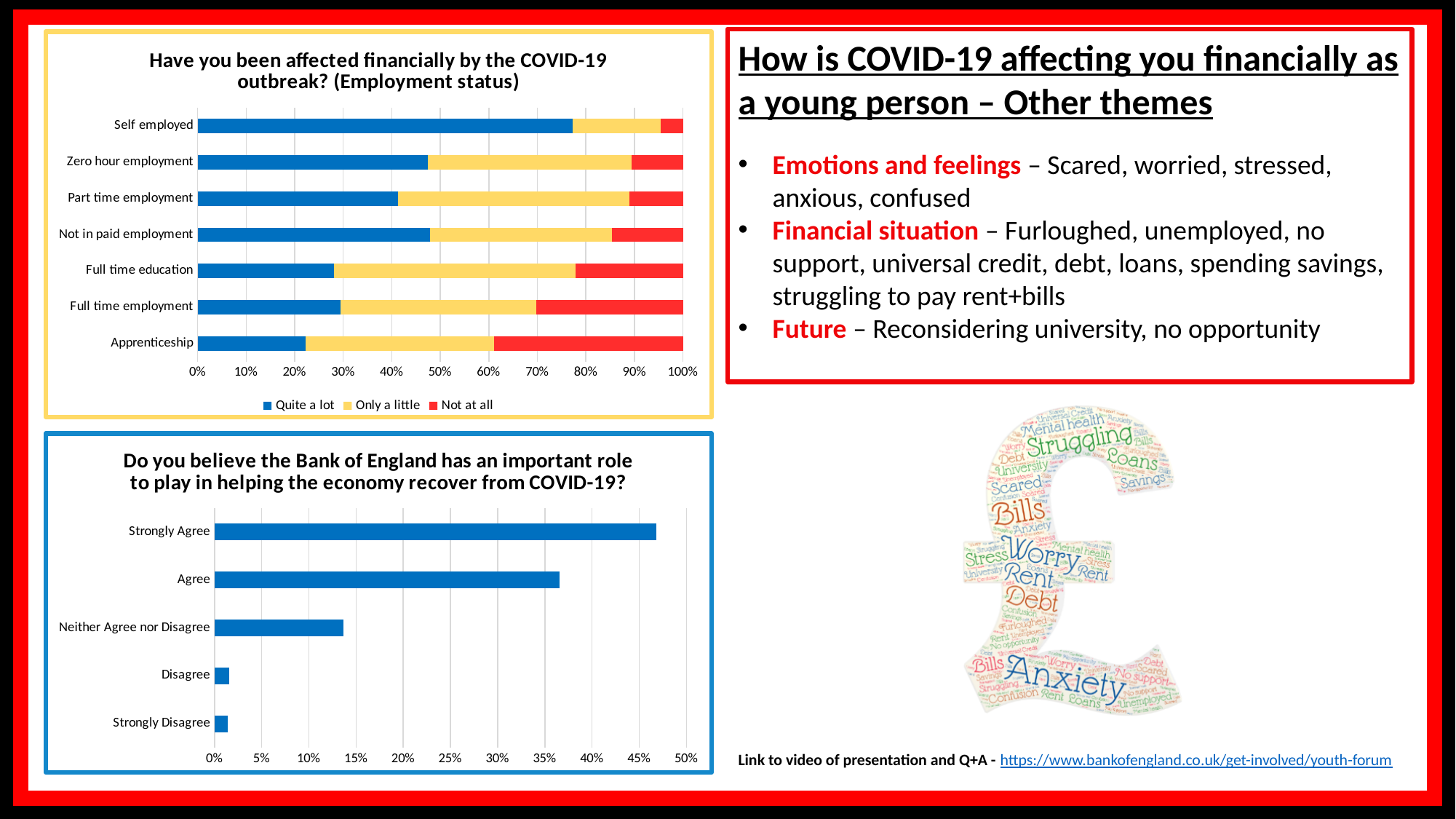
In the chart titled 'Have you been affected financially by the COVID-19 outbreak? (Employment status)', which has the larger 'Quite a lot' share: Zero hour employment or Part time employment? Zero hour employment In the chart titled 'Have you been affected financially by the COVID-19 outbreak? (Employment status)', is the 'Quite a lot' share for Self employed greater or less than 70%? greater In the chart titled 'Have you been affected financially by the COVID-19 outbreak? (Employment status)', which employment status has the smallest 'Quite a lot' share? Apprenticeship In the chart titled 'Have you been affected financially by the COVID-19 outbreak? (Employment status)', which employment status has the largest 'Not at all' share? Apprenticeship In the chart titled 'Do you believe the Bank of England has an important role to play in helping the economy recover from COVID-19?', which response has the highest value? Strongly Agree In the chart titled 'Have you been affected financially by the COVID-19 outbreak? (Employment status)', what colour represents 'Not at all'? Red In the chart titled 'Have you been affected financially by the COVID-19 outbreak? (Employment status)', is the 'Quite a lot' share for Apprenticeship greater or less than 30%? less In the chart titled 'Have you been affected financially by the COVID-19 outbreak? (Employment status)', how many series does the legend list? 3 In the chart titled 'Do you believe the Bank of England has an important role to play in helping the economy recover from COVID-19?', how many response categories are shown? 5 In the chart titled 'Have you been affected financially by the COVID-19 outbreak? (Employment status)', which employment status has the largest 'Quite a lot' share? Self employed In the chart titled 'Have you been affected financially by the COVID-19 outbreak? (Employment status)', how many employment status categories are shown? 7 In the chart titled 'Do you believe the Bank of England has an important role to play in helping the economy recover from COVID-19?', is the value for Strongly Agree greater or less than 45%? greater